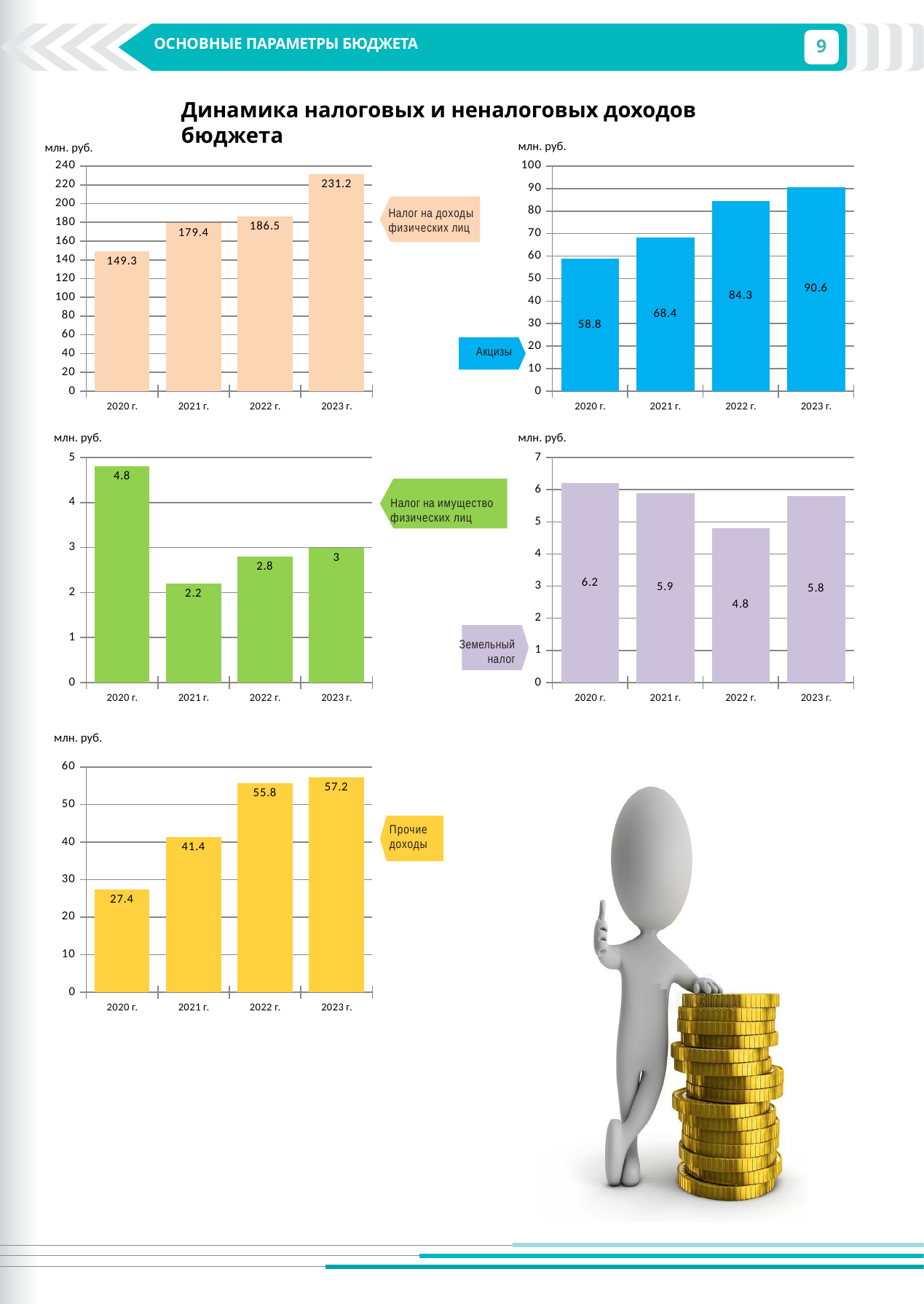
In the 'Налог на доходы физических лиц' chart, which year has the lowest value? 2020 г. In the 'Прочие доходы' chart, how many years are shown on the x axis? 4 In the 'Земельный налог' chart, which year has the lowest value? 2022 г. In the 'Налог на доходы физических лиц' chart, what is the value for 2023 г.? 231.2 In the 'Акцизы' chart, what is the value for 2021 г.? 68.4 In the 'Земельный налог' chart, which is larger, the value for 2020 г. or 2023 г.? 2020 г. In the 'Прочие доходы' chart, what is the value for 2020 г.? 27.4 In the 'Акцизы' chart, do the values rise or fall from 2020 г. to 2023 г.? rise In the 'Налог на имущество физических лиц' chart, what is the value for 2021 г.? 2.2 What type of chart is the 'Прочие доходы' chart? bar chart In the 'Акцизы' chart, what is the difference between the values for 2023 г. and 2020 г.? 31.8 In the 'Налог на имущество физических лиц' chart, which year has the highest value? 2020 г.